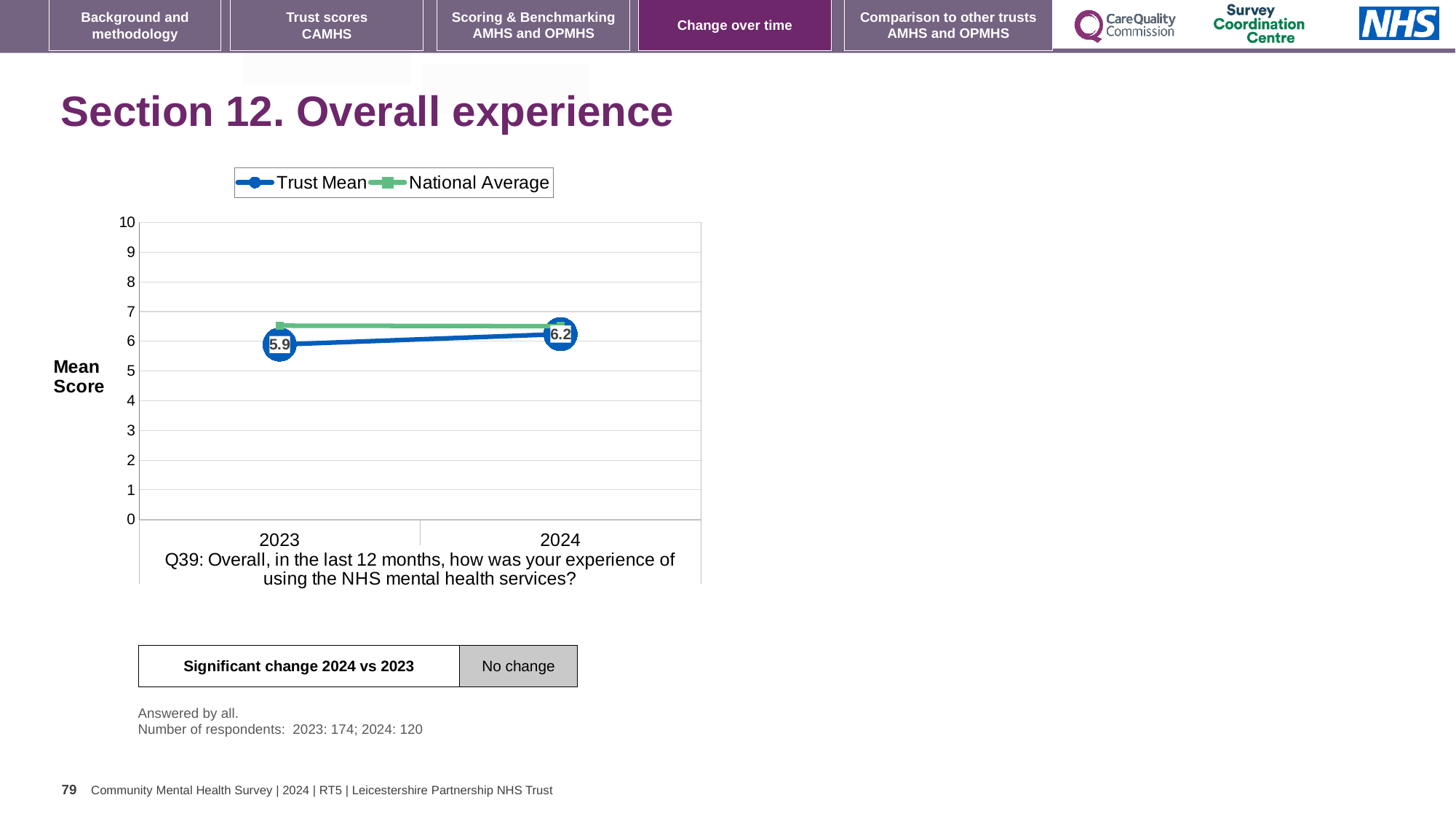
What is the difference between the Trust Mean in 2024 and in 2023? 0.3 What is the Trust Mean value for 2024? 6.2 How many years are plotted on the x axis? 2 What is the label on the y axis of the chart? Mean Score Which year has the higher Trust Mean, 2023 or 2024? 2024 How many series does the legend list? 2 Does the Trust Mean rise or fall from 2023 to 2024? rise What kind of chart is shown on the slide? line chart Is the National Average value for 2023 greater or less than 7? less In 2023, which is larger, the Trust Mean or the National Average? National Average What is the Trust Mean value for 2023? 5.9 Which year has the lowest Trust Mean? 2023